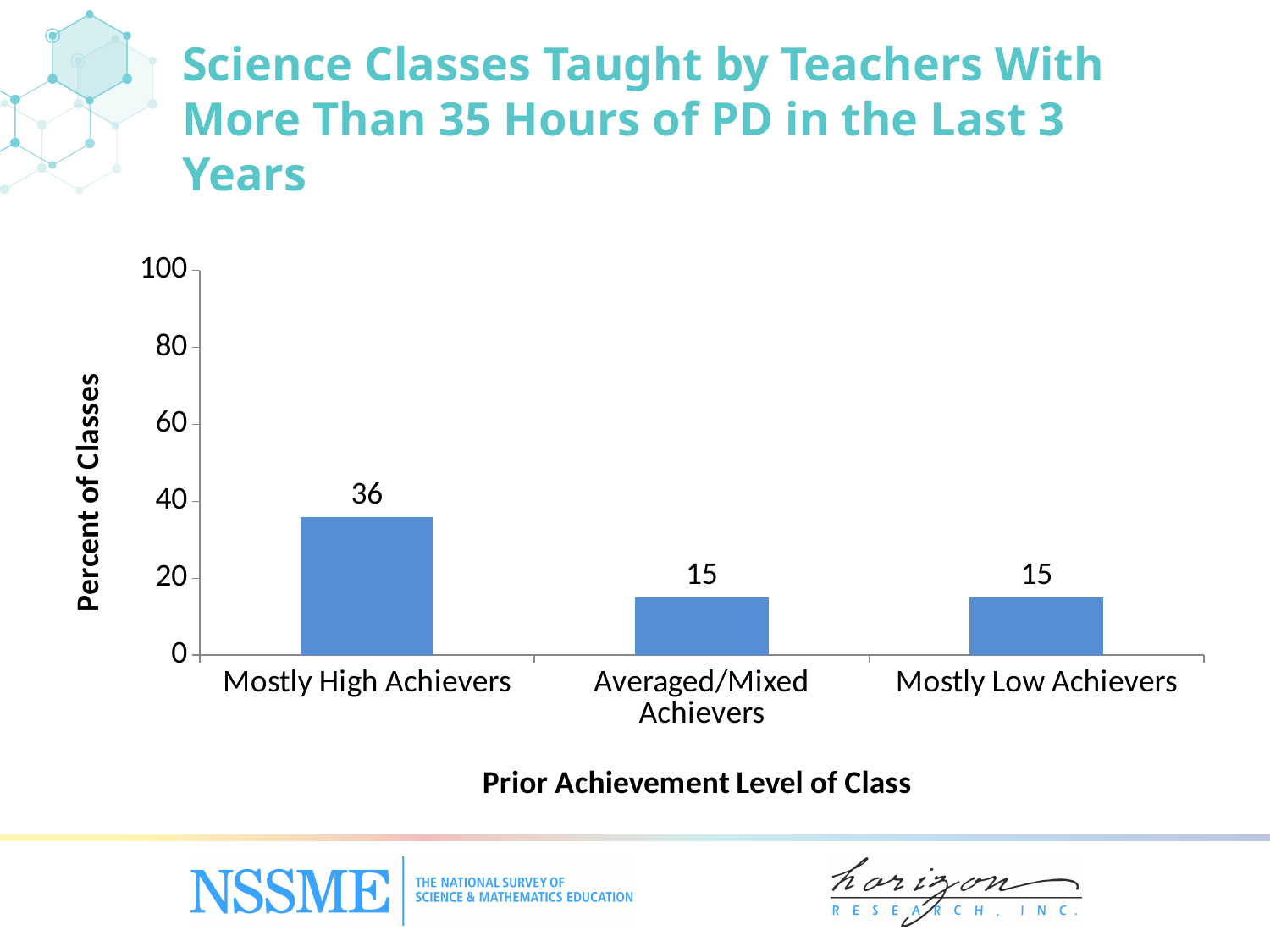
What is the value for Mostly Low Achievers? 15 Which is larger, the value for Mostly High Achievers or the value for Averaged/Mixed Achievers? Mostly High Achievers What is the value for Averaged/Mixed Achievers? 15 Is the value for Mostly Low Achievers greater or less than 20? less Is the value for Mostly High Achievers greater or less than 40? less What is the label of the x axis? Prior Achievement Level of Class What kind of chart is shown on the slide? Bar chart What is the difference between the values for Mostly High Achievers and Mostly Low Achievers? 21 Which category has the highest value? Mostly High Achievers What is the value for Mostly High Achievers? 36 What is the label of the y axis? Percent of Classes How many categories are shown on the x axis? 3